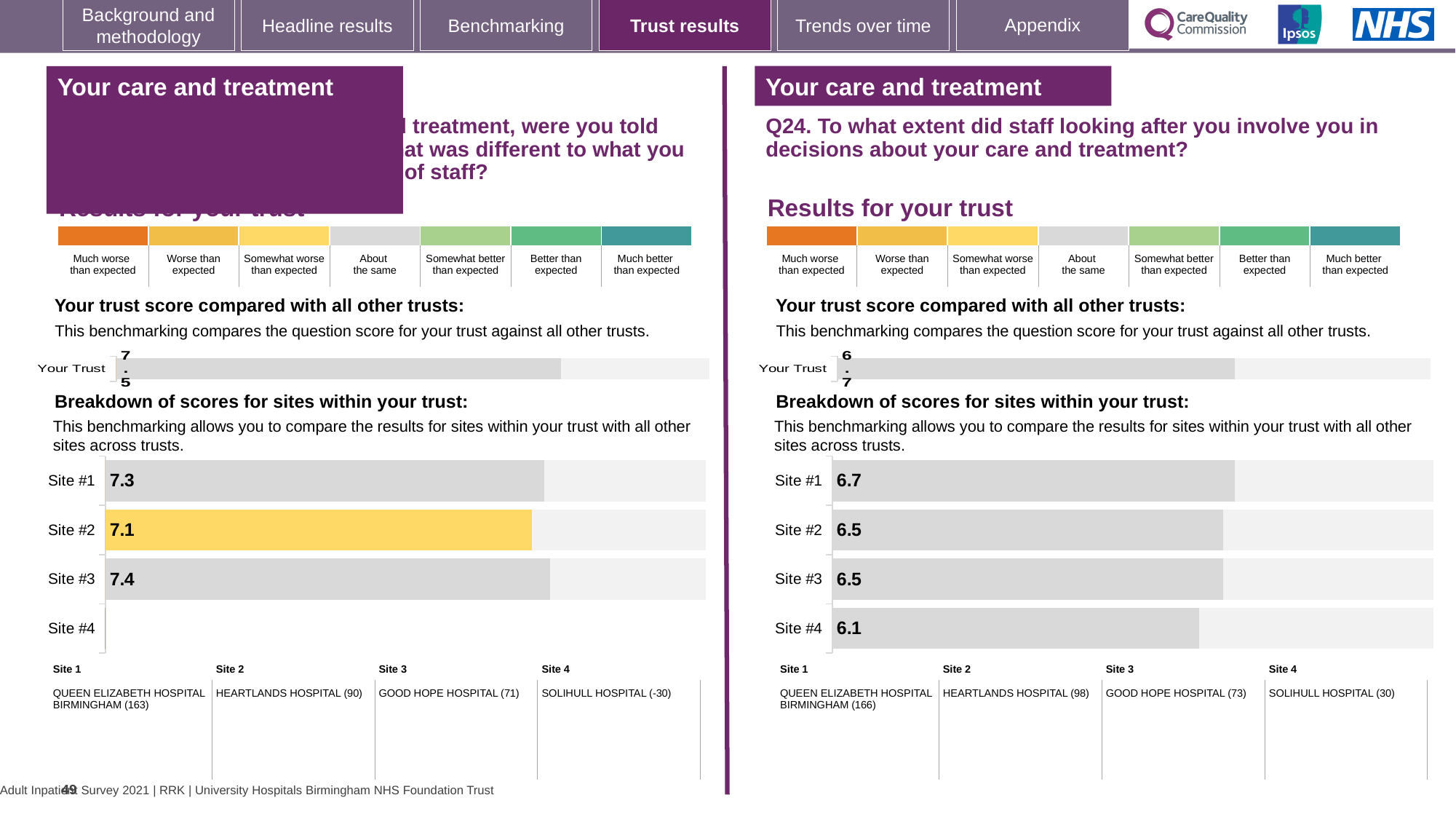
In the left-hand 'Your trust score compared with all other trusts' chart, what is the score for Your Trust? 7.5 In the right-hand (Q24) 'Breakdown of scores for sites within your trust' chart, which site has the highest score? Site #1 In the left-hand 'Breakdown of scores for sites within your trust' chart, which site has the lowest score among those with a bar shown? Site #2 In the left-hand 'Breakdown of scores for sites within your trust' chart, which site has the highest score? Site #3 In the left-hand 'Breakdown of scores for sites within your trust' chart, what is the score for Site #1? 7.3 In the left-hand 'Breakdown of scores for sites within your trust' chart, what is the difference between the scores for Site #3 and Site #2? 0.3 In the right-hand (Q24) 'Breakdown of scores for sites within your trust' chart, what is the difference between the scores for Site #1 and Site #4? 0.6 What kind of chart is used for the 'Breakdown of scores for sites within your trust' on the right-hand side of the slide? Bar chart In the right-hand (Q24) 'Breakdown of scores for sites within your trust' chart, which site has the lowest score? Site #4 In the right-hand (Q24) 'Breakdown of scores for sites within your trust' chart, what is the score for Site #4? 6.1 In the right-hand (Q24) 'Your trust score compared with all other trusts' chart, what is the score for Your Trust? 6.7 In the left-hand 'Breakdown of scores for sites within your trust' chart, what is the score for Site #2? 7.1